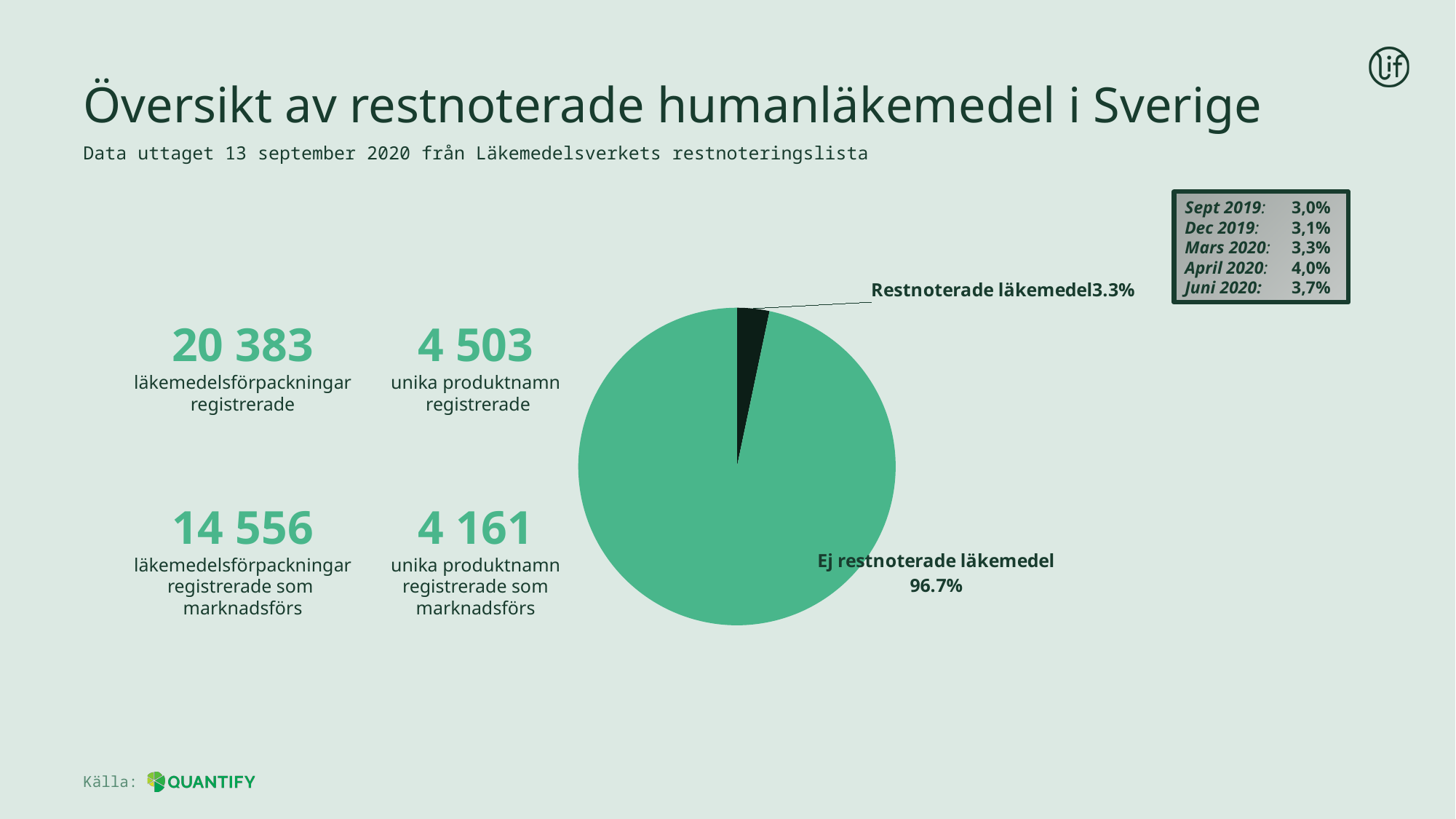
How many slices does the pie chart have? 2 What is the difference in percentage points between the "Ej restnoterade läkemedel" slice and the "Restnoterade läkemedel" slice? 93.4 Which slice of the pie chart is the largest? Ej restnoterade läkemedel What kind of chart is shown on the slide? pie chart What colour is the "Ej restnoterade läkemedel" slice of the pie chart? green What share of the pie does "Ej restnoterade läkemedel" represent? 96.7% Which slice of the pie chart is the smallest? Restnoterade läkemedel Which is larger in the pie chart: "Restnoterade läkemedel" or "Ej restnoterade läkemedel"? Ej restnoterade läkemedel What colour is the "Restnoterade läkemedel" slice of the pie chart? black What share of the pie does "Restnoterade läkemedel" represent? 3.3%